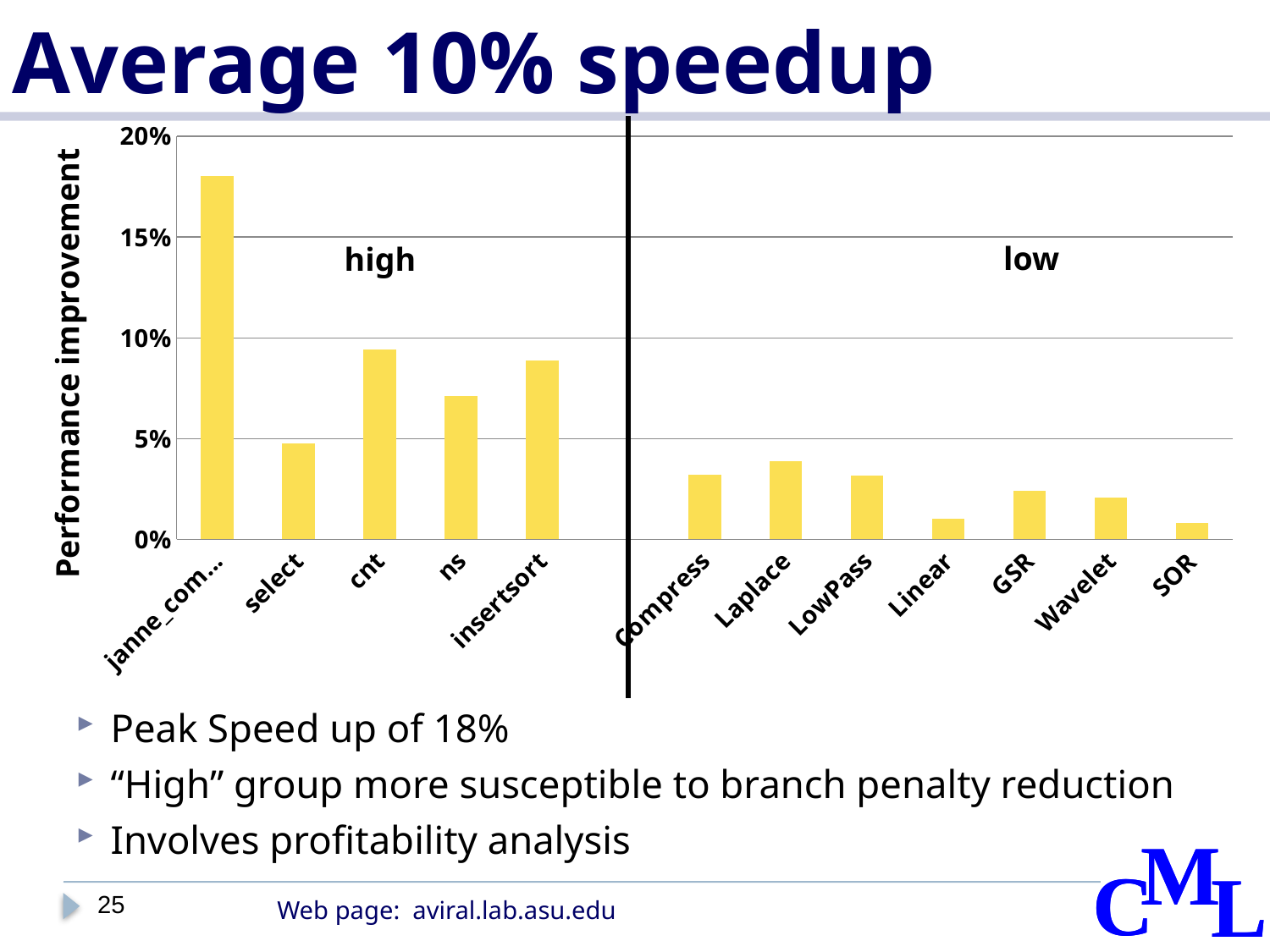
Which has a larger performance improvement, Laplace or Linear? Laplace Which category has the highest performance improvement? janne_com... What kind of chart is shown on the slide? bar chart Is the value for janne_com... greater or less than 15%? greater What is the label of the y axis of the chart? Performance improvement Is the value for insertsort greater or less than 5%? greater How many categories are plotted on the x axis of the chart? 12 Is the value for cnt greater or less than 10%? less Which has a larger performance improvement, cnt or ns? cnt What are the two group labels written inside the chart area? high and low